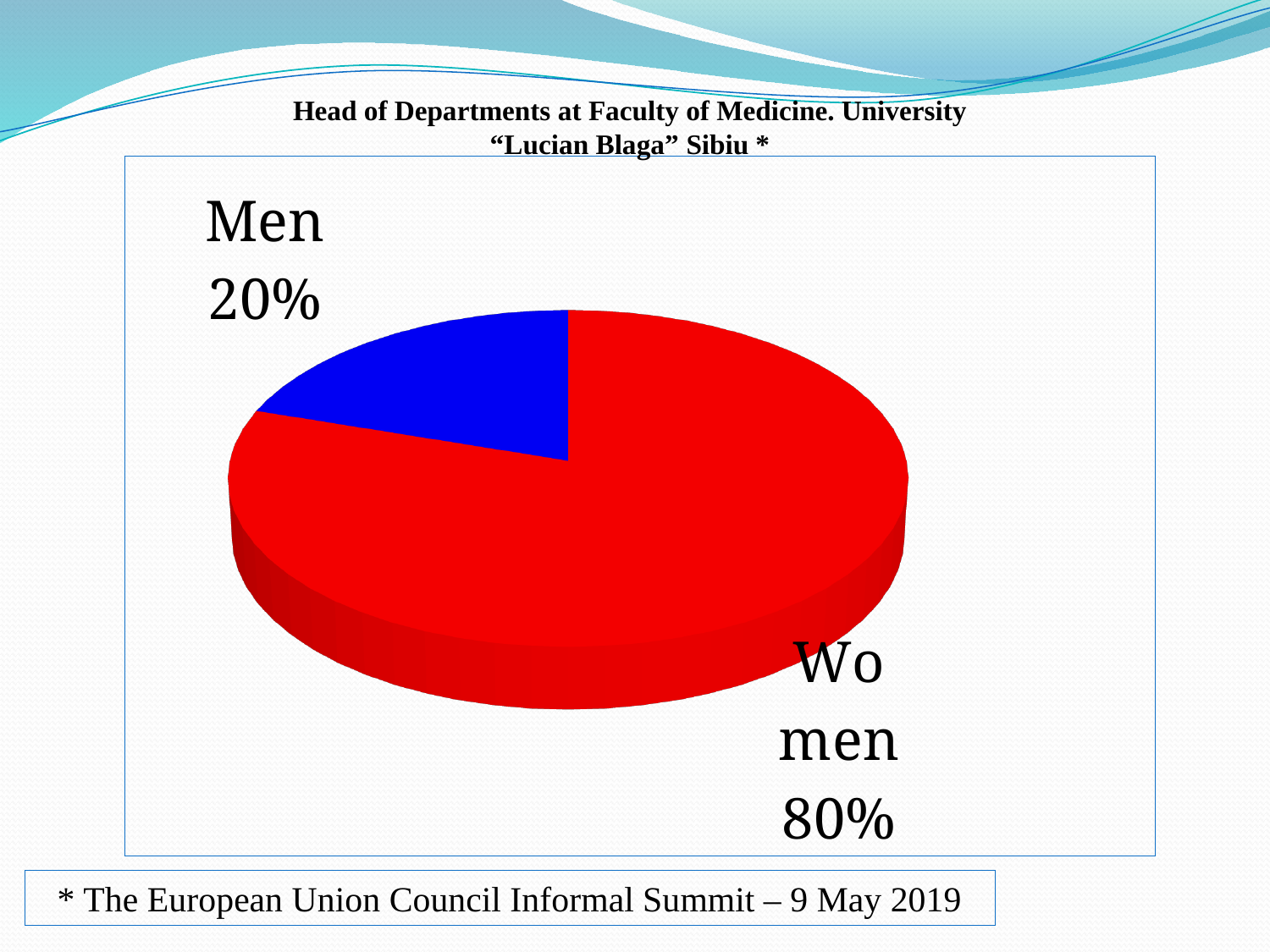
What kind of chart is shown on the slide? pie chart What is the total of the two slice percentages shown? 100% What is the title of the chart? Head of Departments at Faculty of Medicine. University "Lucian Blaga" Sibiu * Which category has the largest slice of the pie? Women How many slices does the pie chart have? 2 What colour is the Men slice? blue Which slice is larger, Men or Women? Women What is the difference in percentage points between the Women and Men slices? 60 What share of the pie is labelled Men? 20% Which category has the smallest slice of the pie? Men What share of the pie is labelled Women? 80%